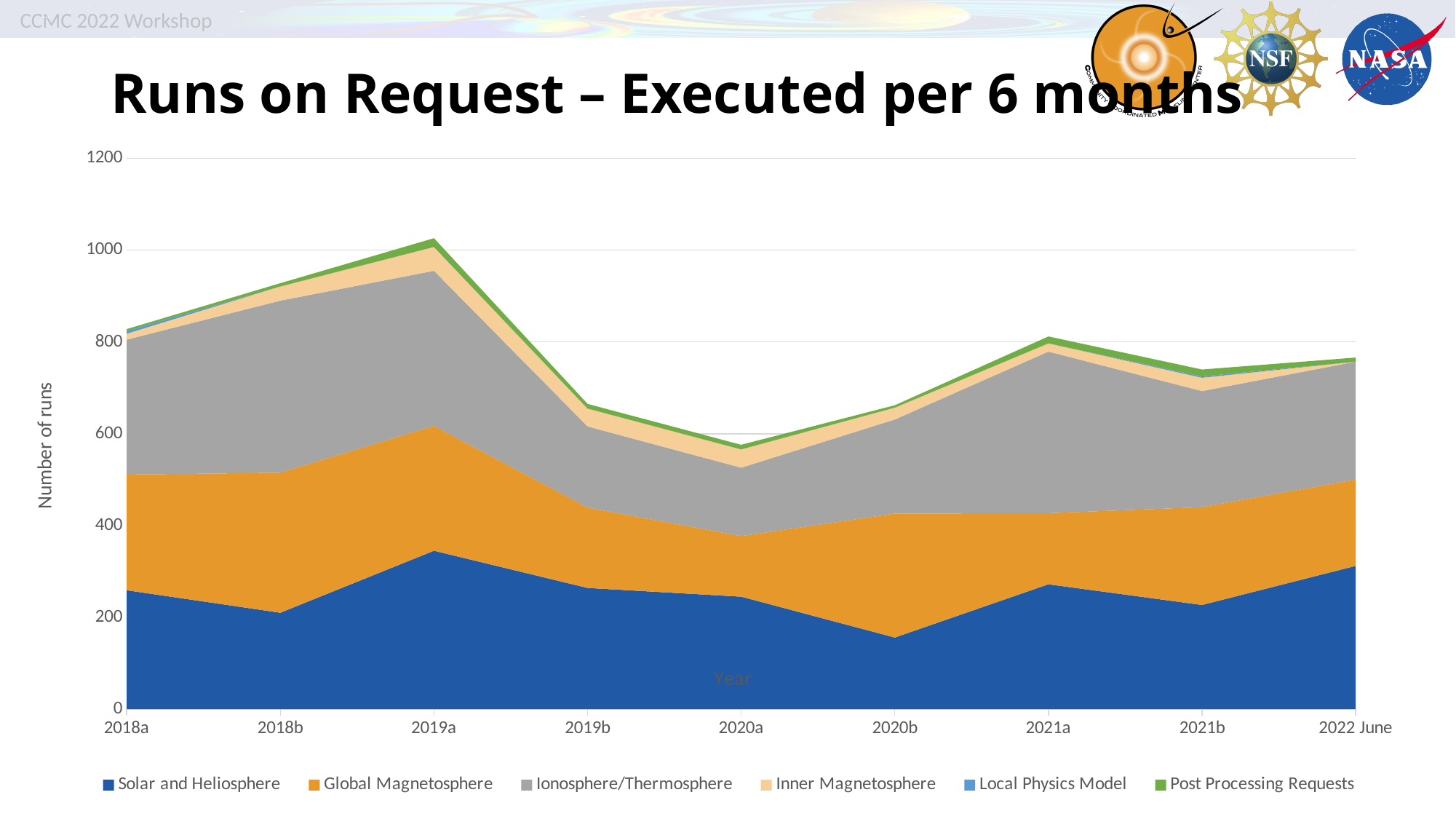
Which period has a larger total number of runs, 2018b or 2019b? 2018b Is the total number of runs for 2020a greater or less than 600? less In which period is the total number of runs lowest? 2020a What is the label of the y axis? Number of runs In which period is the total number of runs highest? 2019a Is the total number of runs for 2021b greater or less than 800? less How many series does the legend list? 6 How many time periods are shown along the x axis? 9 Does the total number of runs rise or fall from 2019a to 2020a? fall Is the Solar and Heliosphere value for 2019a greater or less than 300? greater In which period is the Solar and Heliosphere value lowest? 2020b What kind of chart is shown on the slide? Stacked area chart